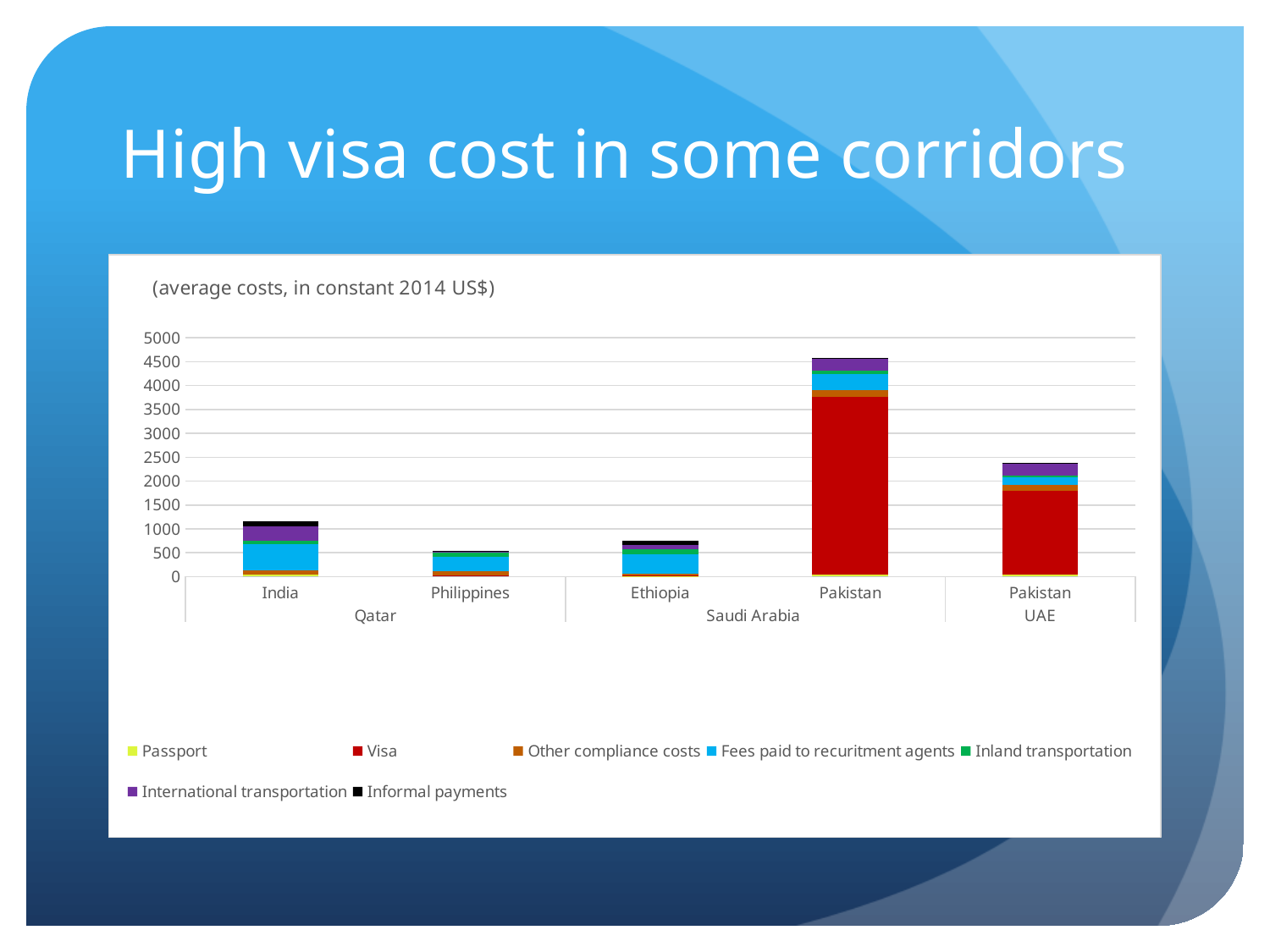
How many bars (corridors) are plotted in the chart? 5 Is the total cost for Pakistan (UAE) greater or less than 2000? greater Which corridor has the highest total cost? Pakistan (Saudi Arabia) What unit does the chart subtitle say the costs are in? Constant 2014 US$ Is the total cost for Pakistan (Saudi Arabia) greater or less than 4000? greater Is the total cost for Philippines (Qatar) greater or less than 1000? less Which corridor has the lowest total cost? Philippines (Qatar) What kind of chart is shown on the slide? Stacked bar chart Which has a larger total cost, Ethiopia (Saudi Arabia) or Philippines (Qatar)? Ethiopia (Saudi Arabia) Which has a larger total cost, India (Qatar) or Pakistan (UAE)? Pakistan (UAE) How many series does the legend list? 7